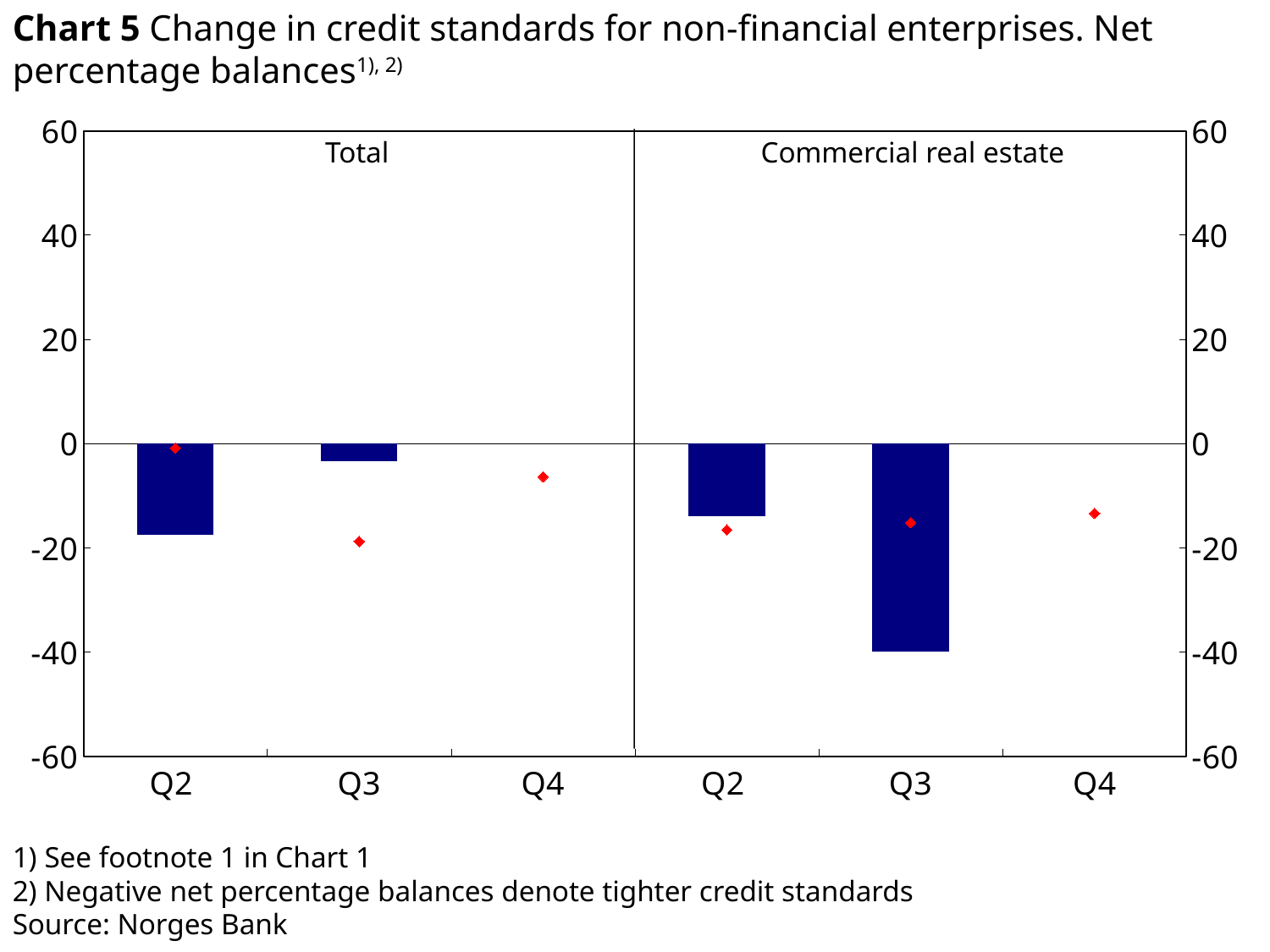
In the Total panel, is the bar for Q2 greater or less than -10? less What kind of chart is this? bar chart How many quarters are shown on the x axis of each panel? 3 In the Total panel, is the bar for Q3 greater or less than -10? greater Which panel contains the lowest bar, Total or Commercial real estate? Commercial real estate In the Commercial real estate panel, is the bar for Q2 greater or less than -10? less Which bar in the whole chart is the lowest (most negative)? Commercial real estate Q3 What are the two panels of the chart labelled? Total and Commercial real estate What is the source given for the chart? Norges Bank In the Total panel, which bar is lower, Q2 or Q3? Q2 What is the highest value shown on the vertical axis? 60